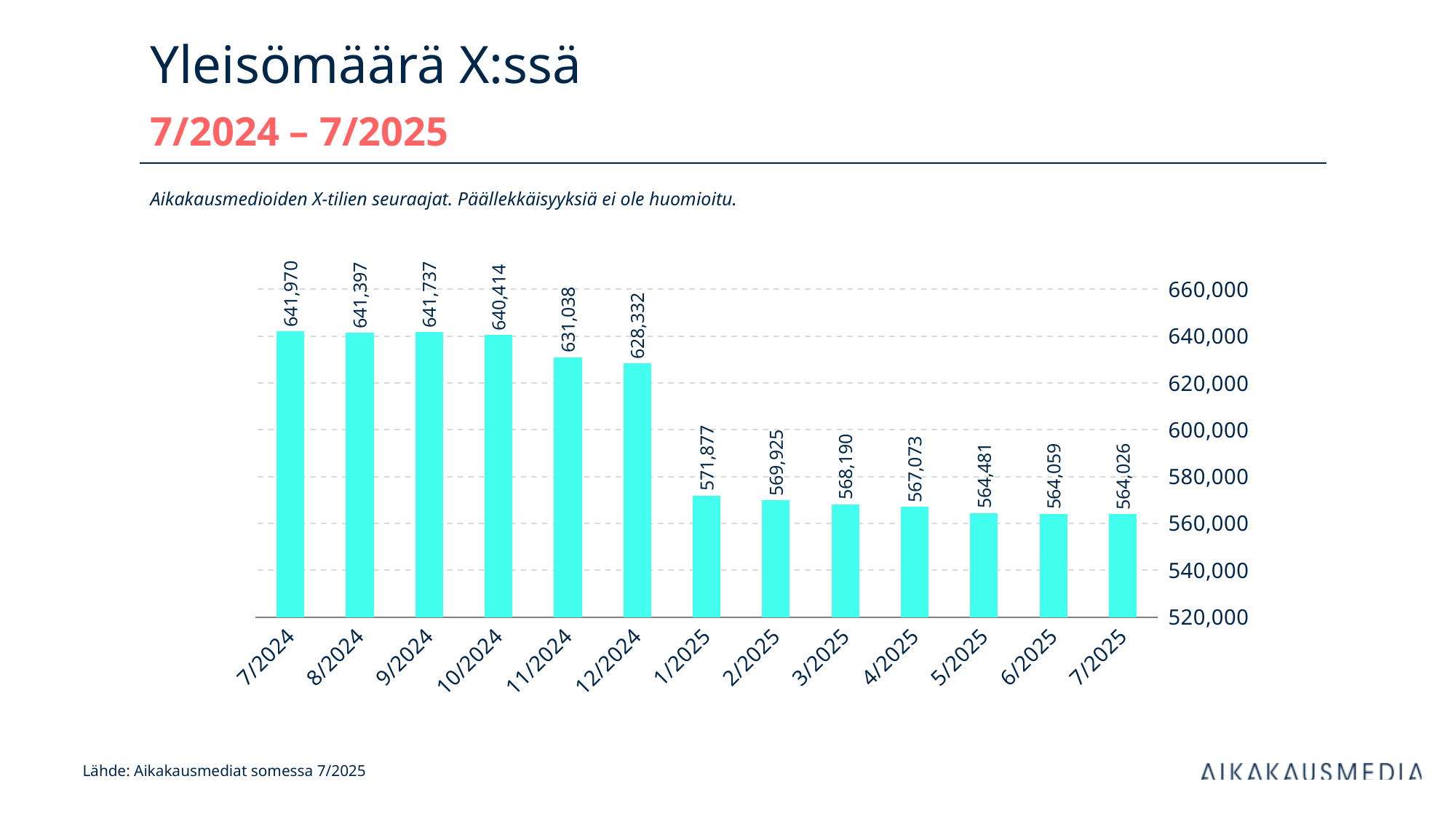
What is the difference between the values for 12/2024 and 1/2025? 56,455 Do the values generally rise or fall from 7/2024 to 7/2025? fall How many months are shown on the x axis? 13 Is the value for 11/2024 greater or less than 620,000? greater Which is larger, the value for 10/2024 or the value for 11/2024? 10/2024 What is the value for 7/2025? 564,026 What kind of chart is shown on the slide? bar chart What is the value for 1/2025? 571,877 What is the value for 7/2024? 641,970 Which month has the highest value? 7/2024 What is the difference between the values for 7/2024 and 7/2025? 77,944 Which month has the lowest value? 7/2025